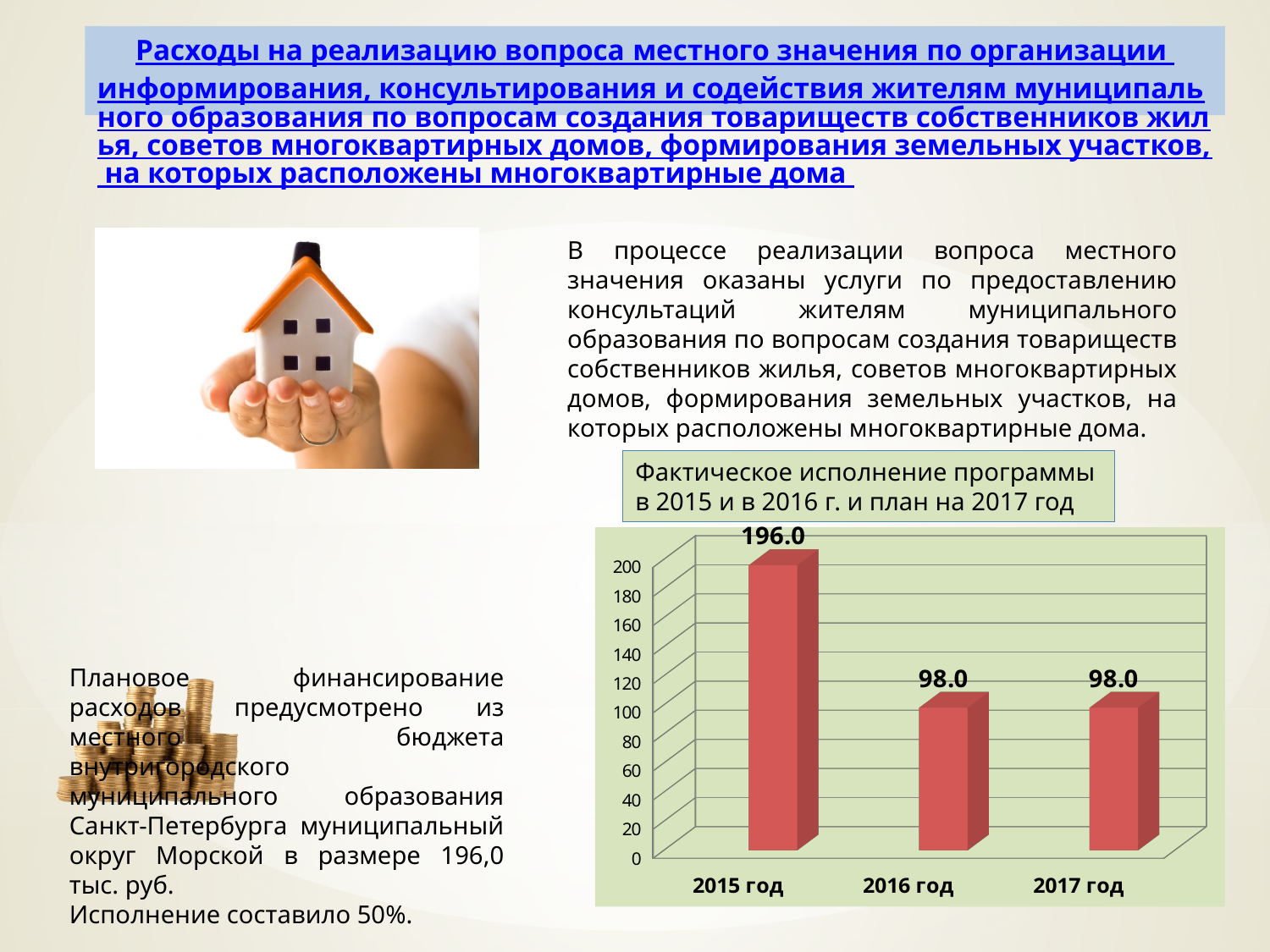
How many categories are shown on the x axis? 3 Which year has the highest value? 2015 год Do the values rise or fall from 2015 год to 2016 год? fall What is the difference between the values for 2015 год and 2016 год? 98.0 Is the value for 2016 год greater or less than 100? less Is the value for 2015 год greater or less than 180? greater What is the title shown above the chart? Фактическое исполнение программы в 2015 и в 2016 г. и план на 2017 год What is the value for 2017 год? 98.0 What is the value for 2015 год? 196.0 What kind of chart is shown on the slide? bar chart Which is larger, the value for 2015 год or the value for 2017 год? 2015 год What is the value for 2016 год? 98.0